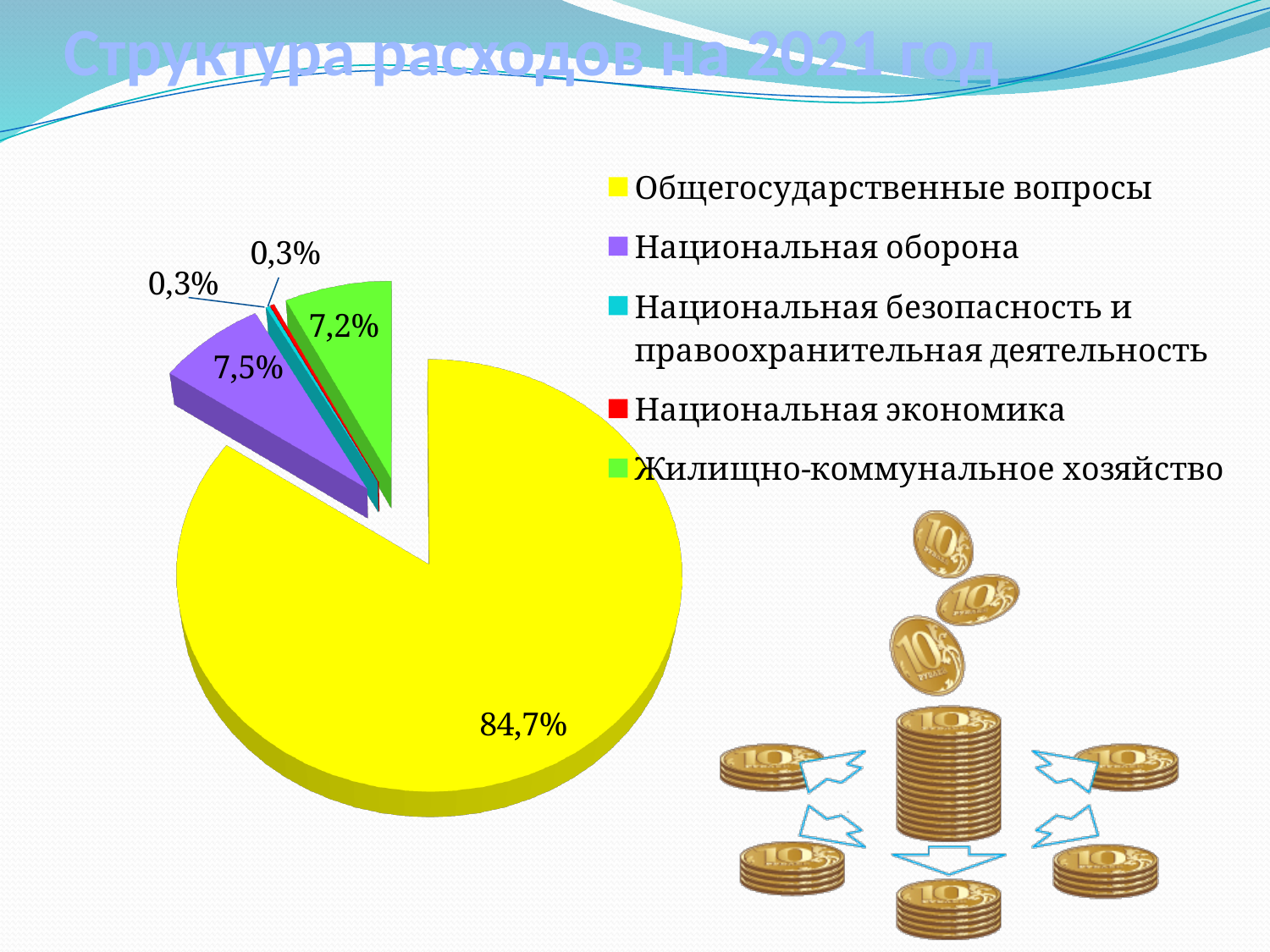
What is the value shown for Национальная экономика? 0,3% Which is larger, Национальная оборона or Жилищно-коммунальное хозяйство? Национальная оборона What is the value shown for Жилищно-коммунальное хозяйство? 7,2% What share of the pie does Общегосударственные вопросы have? 84,7% What is the value shown for Национальная оборона? 7,5% Which category has the largest slice of the pie? Общегосударственные вопросы What colour is the slice for Национальная оборона? Purple What is the value shown for Национальная безопасность и правоохранительная деятельность? 0,3% What is the title of the chart slide? Структура расходов на 2021 год How many categories does the legend list? 5 What is the difference between the shares of Национальная оборона and Жилищно-коммунальное хозяйство? 0,3% What kind of chart is shown on the slide? Pie chart